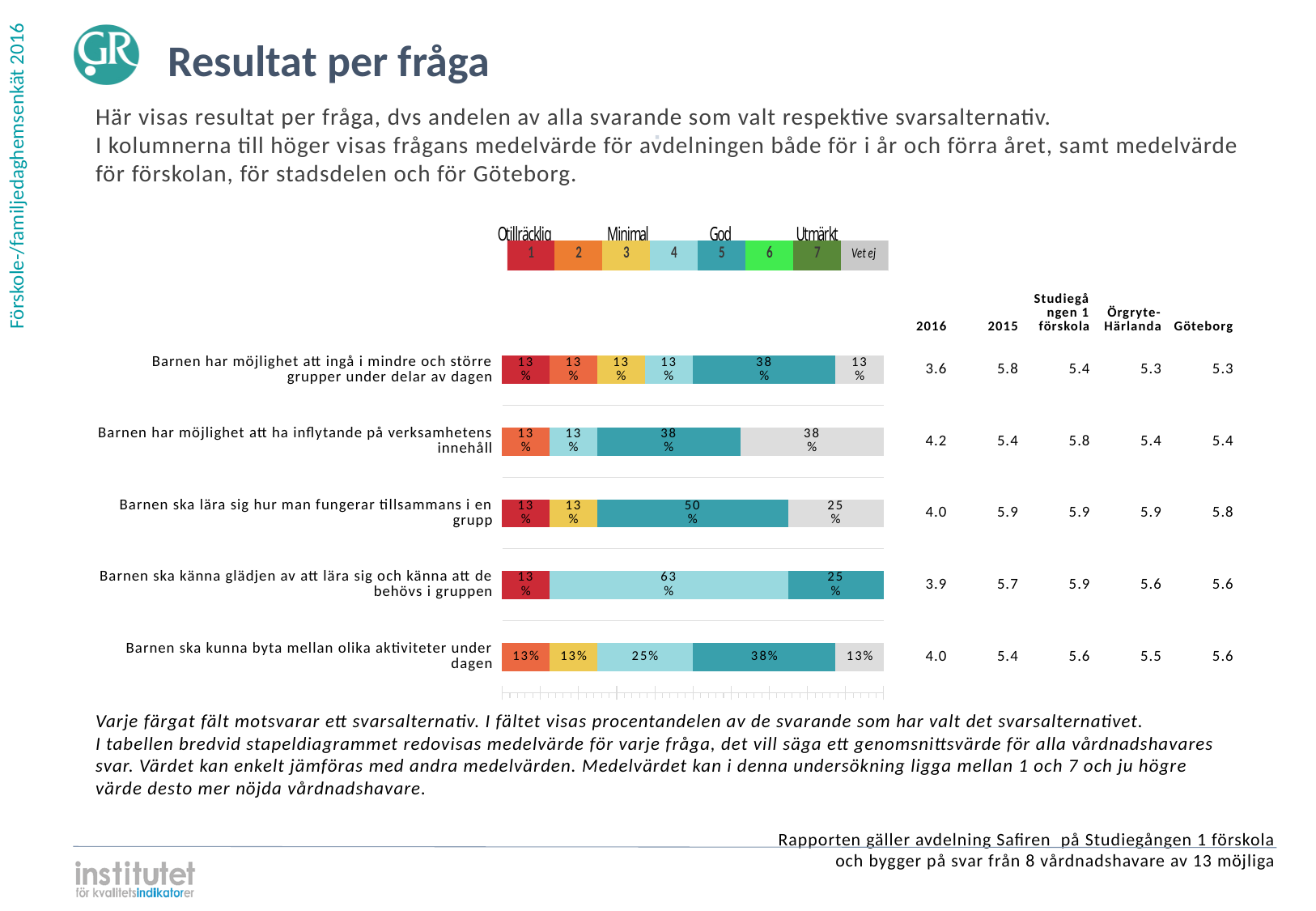
Which question has the lowest 2016 mean value in the table? Barnen har möjlighet att ingå i mindre och större grupper under delar av dagen What percentage chose answer 5 for 'Barnen ska kunna byta mellan olika aktiviteter under dagen'? 38% What percentage of respondents chose answer 4 for 'Barnen ska känna glädjen av att lära sig och känna att de behövs i gruppen'? 63% What percentage of respondents chose answer 5 (God) for 'Barnen ska lära sig hur man fungerar tillsammans i en grupp'? 50% How many answer alternatives does the legend above the chart list? 8 What kind of chart is shown on the slide? Stacked bar chart How many questions (categories) are plotted in the bar chart? 5 Which answer alternative has the largest share for 'Barnen har möjlighet att ingå i mindre och större grupper under delar av dagen'? 5 For 'Barnen ska kunna byta mellan olika aktiviteter under dagen', what is the difference between the share for answer 5 and the share for answer 4? 13% What is the Göteborg mean value for 'Barnen ska lära sig hur man fungerar tillsammans i en grupp'? 5.8 What is the 2016 mean value for 'Barnen har möjlighet att ha inflytande på verksamhetens innehåll'? 4.2 What is the 'Vet ej' share for 'Barnen har möjlighet att ha inflytande på verksamhetens innehåll'? 38%